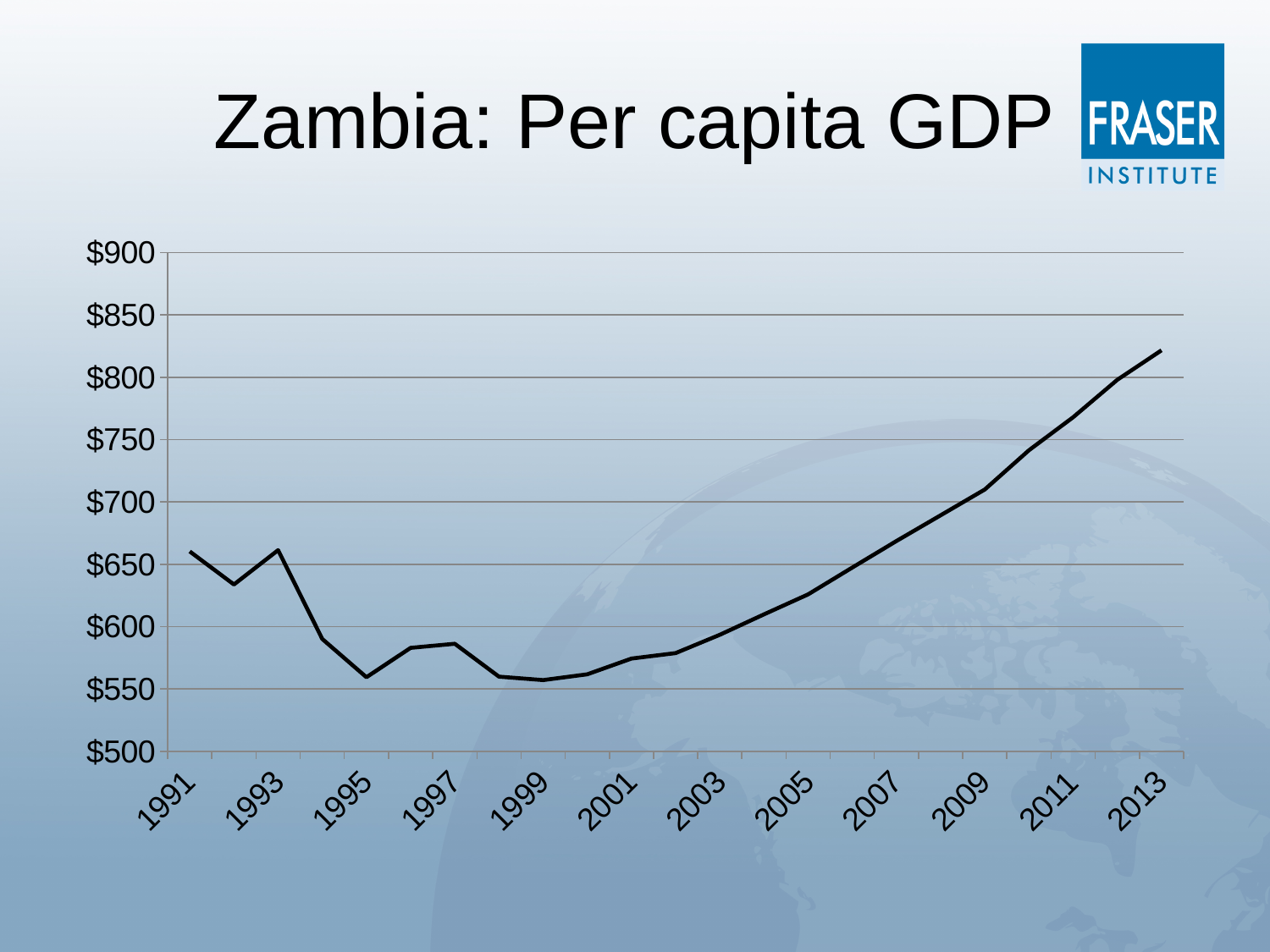
What is the title of the chart? Zambia: Per capita GDP Which is larger, the value for 2011 or the value for 2001? 2011 Is the value for 2005 greater or less than $600? greater Is the value for 1999 greater or less than $600? less Is the value for 1991 greater or less than $650? greater Which year has the highest per capita GDP on the chart? 2013 How many year labels are shown on the x axis? 12 Does per capita GDP rise or fall between 1999 and 2013? rise What kind of chart is shown on the slide? line chart Which is larger, the value for 1993 or the value for 1995? 1993